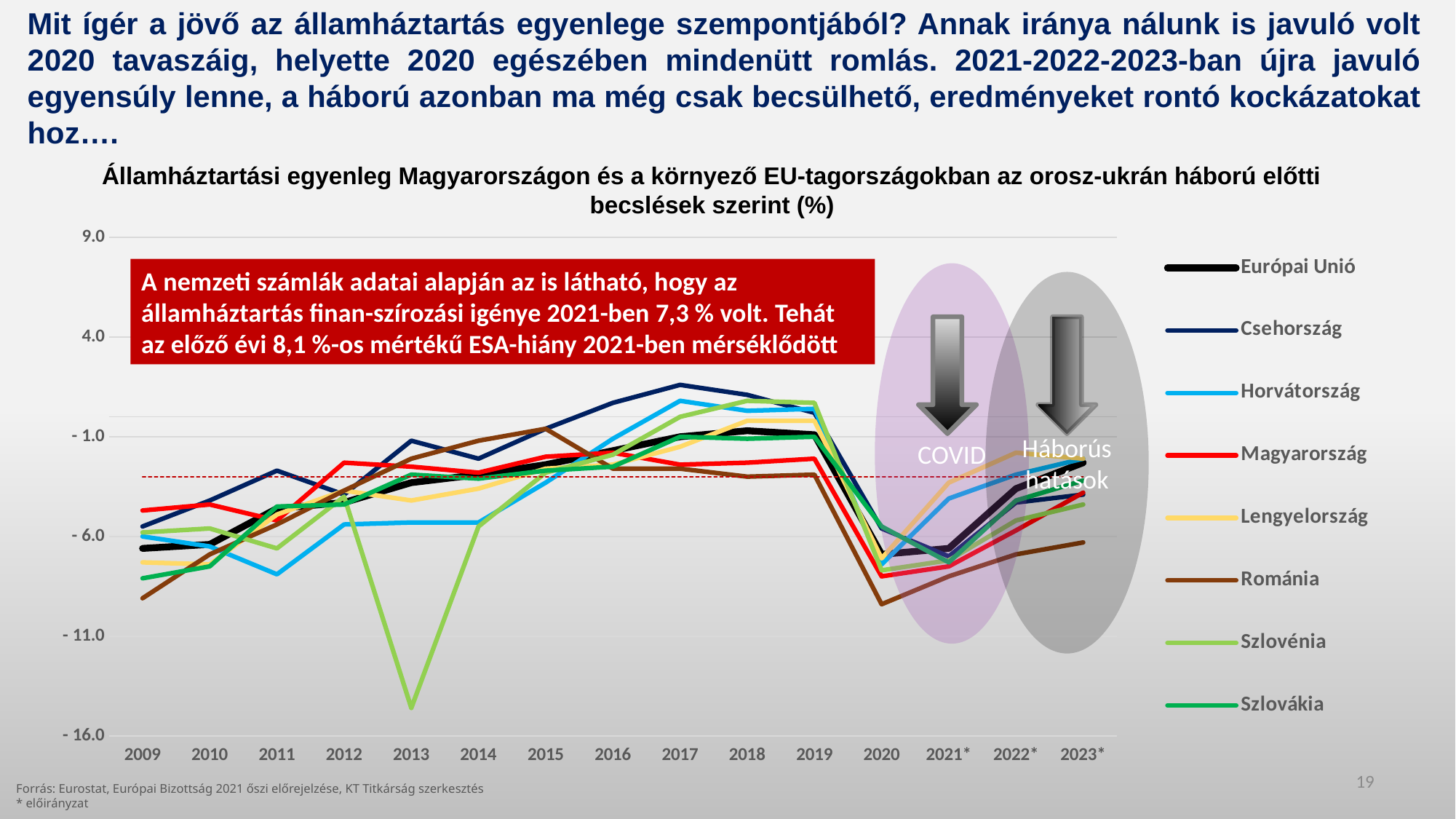
What kind of chart is shown on the slide? line chart Is the value for Magyarország in 2020 greater or less than -6.0? less Which series is drawn with a black line according to the legend? Európai Unió How many series does the legend list? 8 Which series reaches the lowest point on the chart? Szlovénia In 2020, which is higher: Magyarország or Románia? Magyarország Is the value for Románia in 2020 greater or less than -6.0? less In which year does Szlovénia reach its lowest value? 2013 Does the value for Magyarország rise or fall from 2019 to 2020? fall How many years are shown along the x axis? 15 Is the value for Szlovénia in 2013 greater or less than -11.0? less